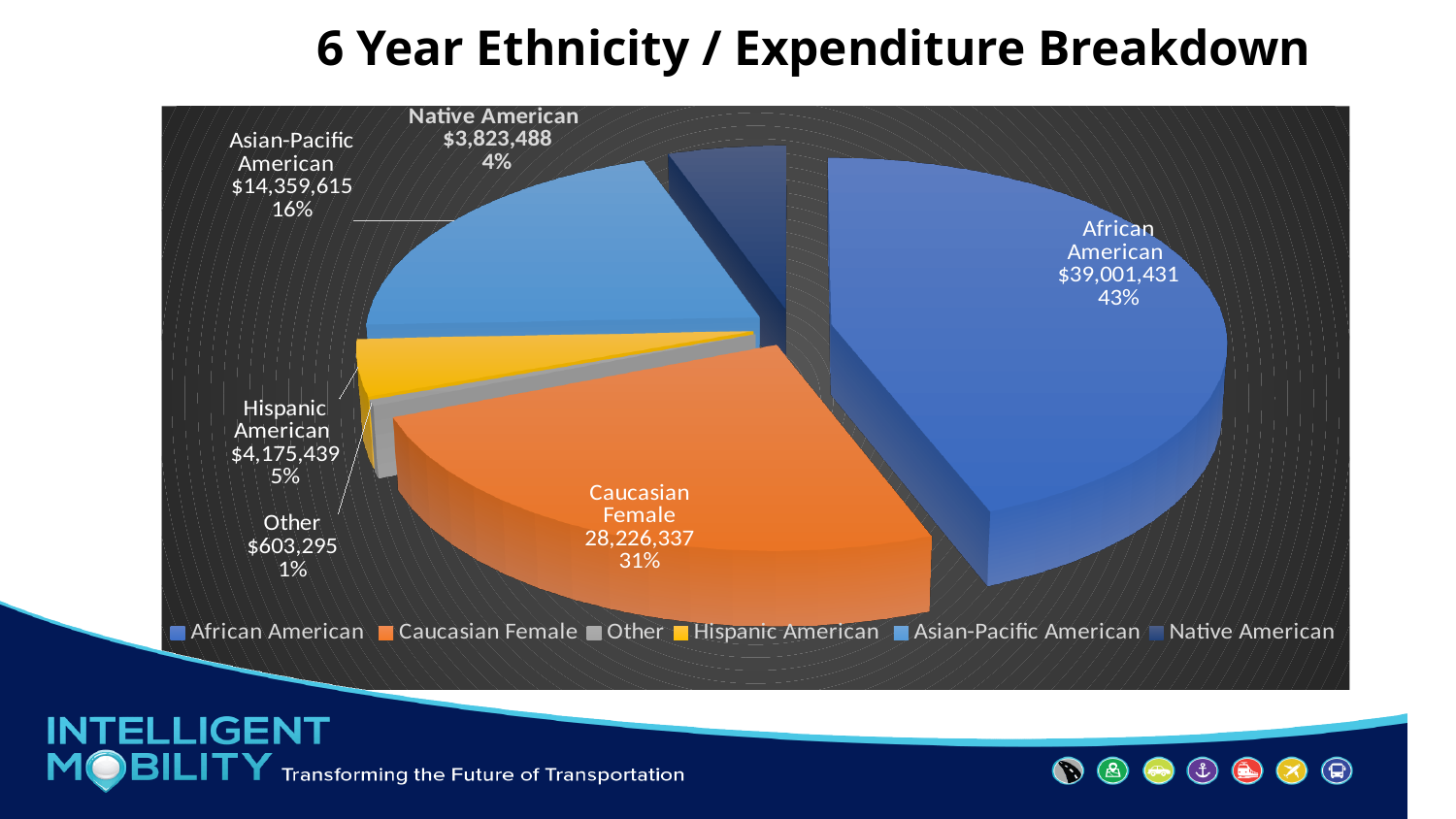
How many categories are shown in the pie chart? 6 What is the expenditure value shown for Native American? $3,823,488 What percentage share does the Caucasian Female slice represent? 31% What is the title of the chart? 6 Year Ethnicity / Expenditure Breakdown What is the expenditure value shown for African American? $39,001,431 What is the difference between the African American and Asian-Pacific American expenditure values? $24,641,816 What is the expenditure value shown for Other? $603,295 What percentage share does the Asian-Pacific American slice represent? 16% Which category has the largest slice of the pie? African American Which category has the smallest slice of the pie? Other Which is larger, the Hispanic American value or the Native American value? Hispanic American What kind of chart is shown on the slide? Pie chart